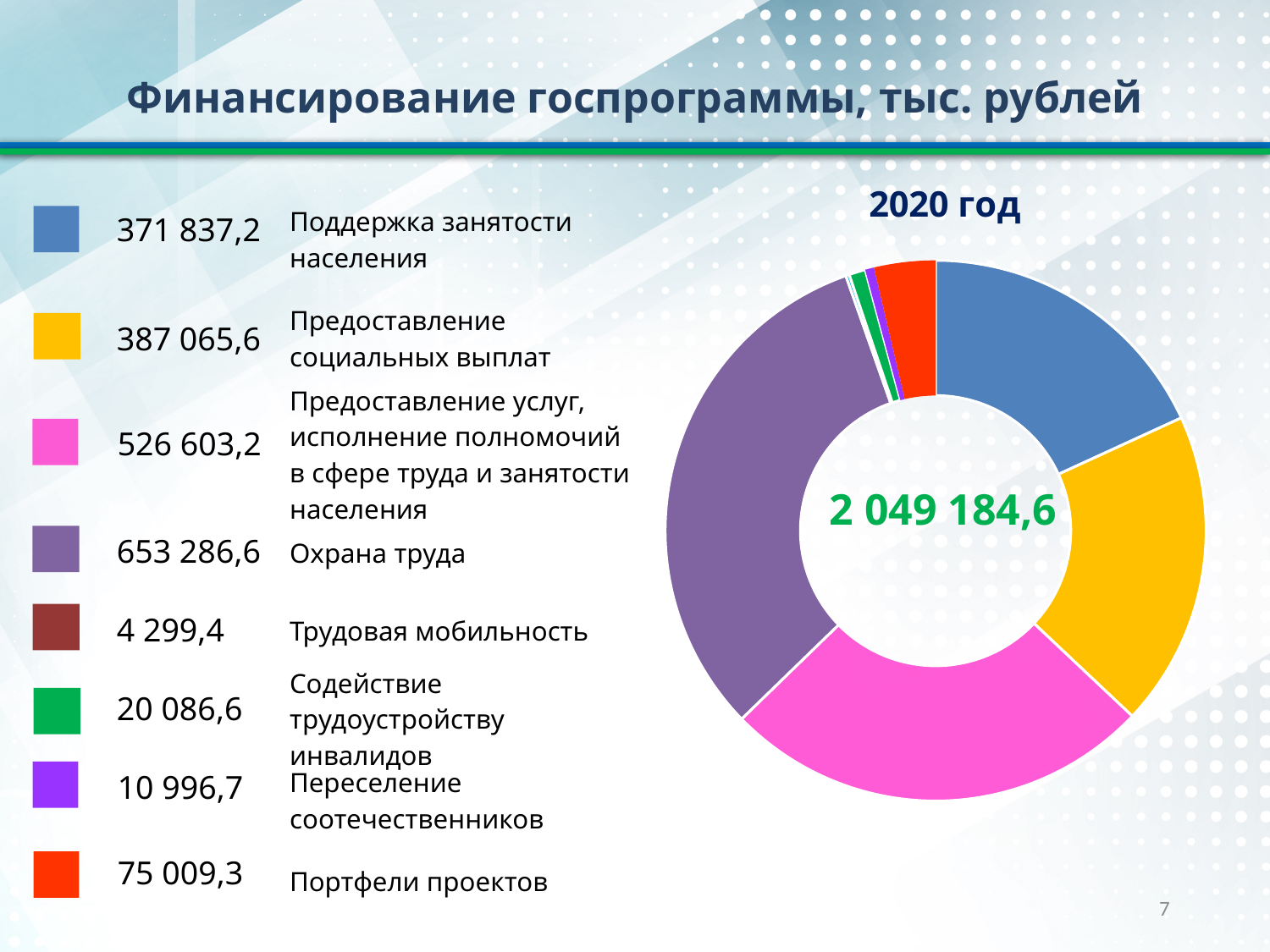
What is the difference between Охрана труда and Поддержка занятости населения? 281 449,4 Which category has the highest value? Охрана труда What is the value for Переселение соотечественников? 10 996,7 What is the total value shown in the centre of the chart? 2 049 184,6 Which is larger: Предоставление социальных выплат or Предоставление услуг, исполнение полномочий в сфере труда и занятости населения? Предоставление услуг, исполнение полномочий в сфере труда и занятости населения What is the value for Охрана труда? 653 286,6 What is the value for Портфели проектов? 75 009,3 Which category has the lowest value? Трудовая мобильность What year does the chart refer to? 2020 год What kind of chart is shown on the slide? Doughnut chart What colour represents Содействие трудоустройству инвалидов? Green How many categories does the chart show? 8